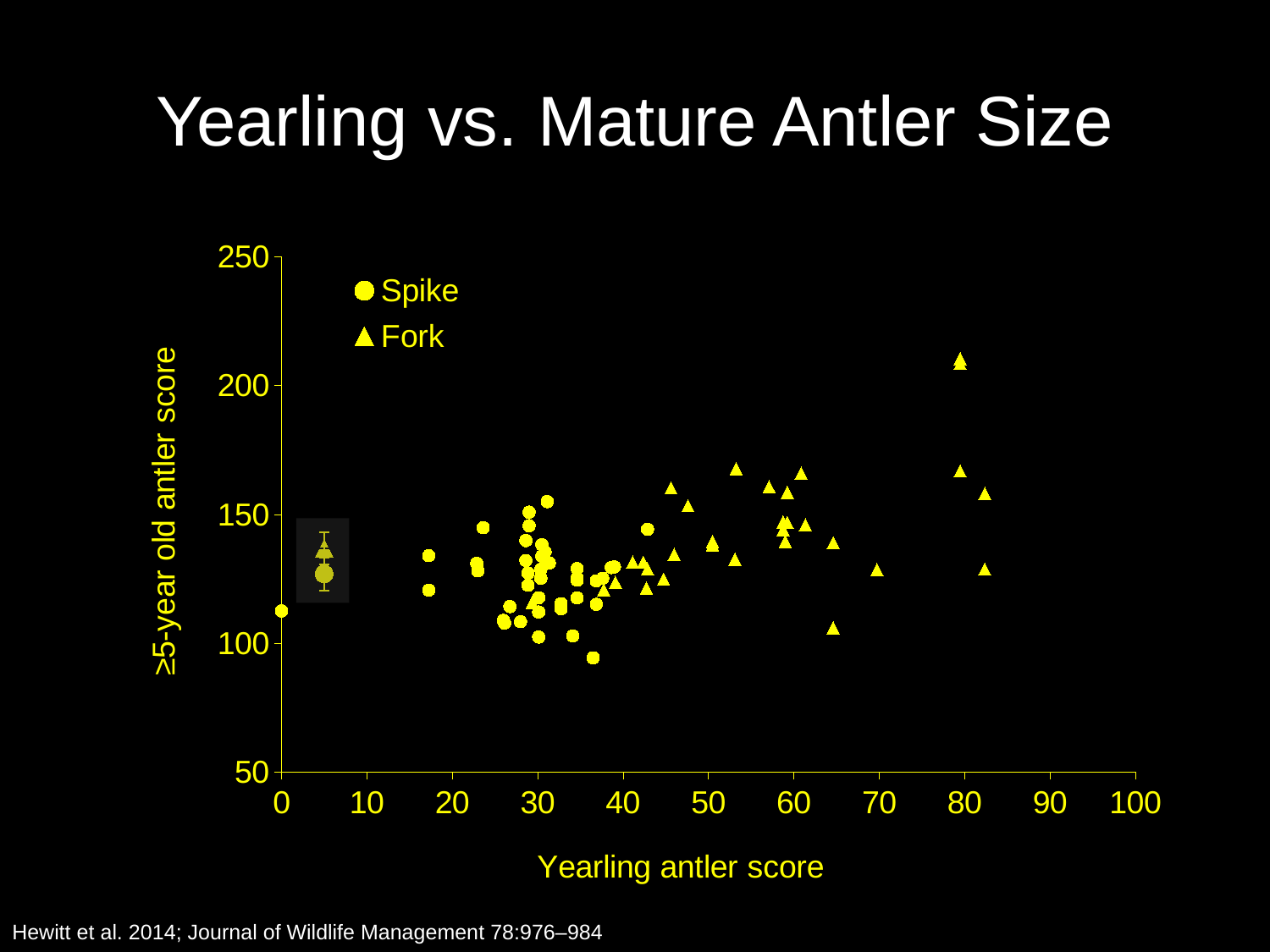
Which series contains the point with the highest ≥5-year old antler score? Fork What kind of chart is shown on the slide? scatter chart Is the lowest ≥5-year old antler score plotted greater or less than 100? less Is the highest ≥5-year old antler score plotted greater or less than 200? greater How many series does the legend list? 2 What is the highest value shown on the x axis? 100 As yearling antler score increases along the x axis, do the ≥5-year old antler scores generally rise or fall? rise Which series contains the point with the lowest ≥5-year old antler score? Spike Is the ≥5-year old antler score of the Spike point at a yearling antler score of 0 greater or less than 150? less What is the title of the chart? Yearling vs. Mature Antler Size What are the two series named in the legend? Spike and Fork Which series has points at yearling antler scores above 70, Spike or Fork? Fork